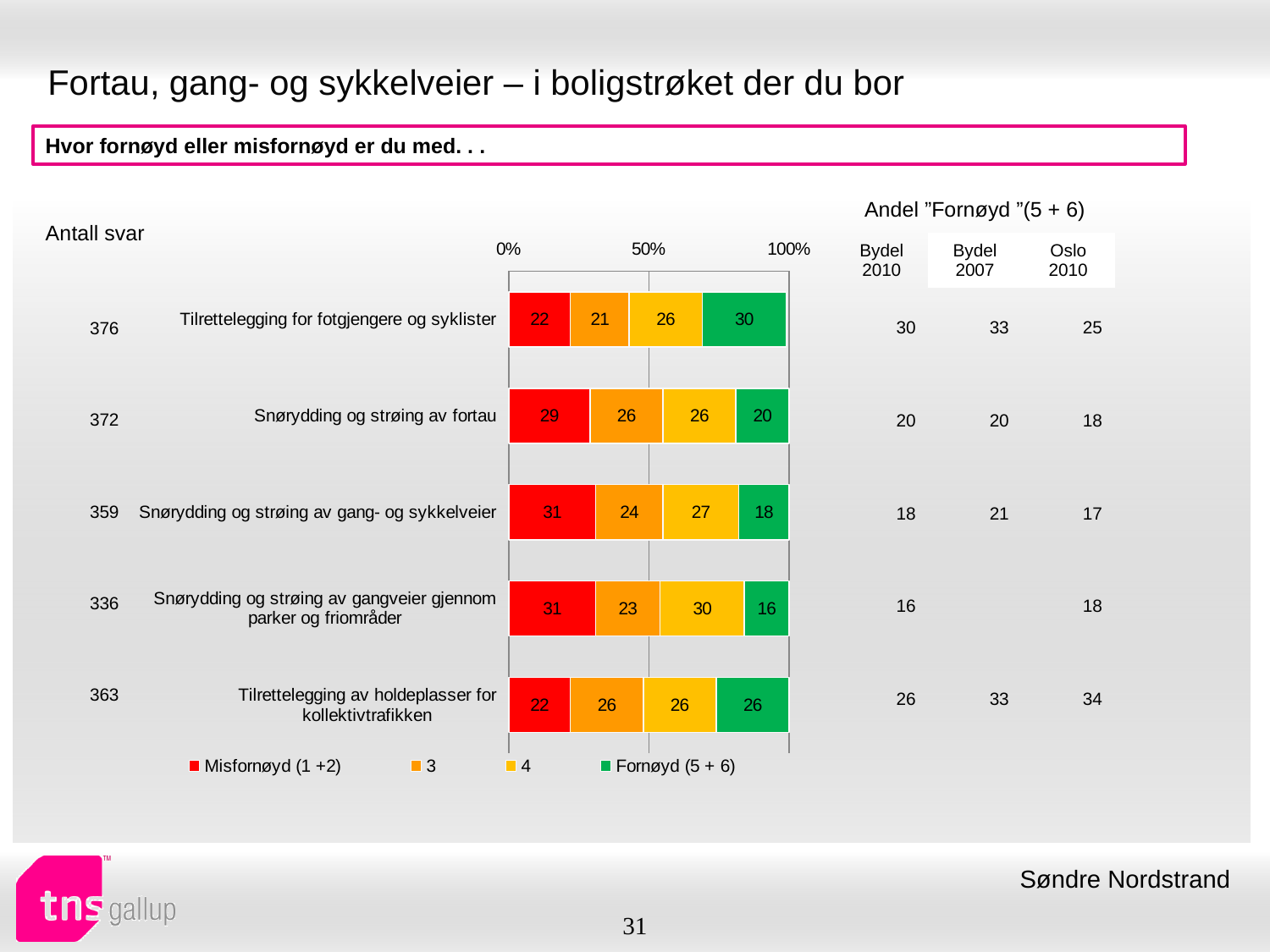
Which category has the lowest Fornøyd (5 + 6) value? Snørydding og strøing av gangveier gjennom parker og friområder How many series does the legend list? 4 What colour represents the Fornøyd (5 + 6) series in the chart? Green What kind of chart is shown on the slide? Stacked bar chart What is the difference between the Fornøyd (5 + 6) values for "Tilrettelegging for fotgjengere og syklister" and "Snørydding og strøing av gangveier gjennom parker og friområder"? 14 What is the value of the "4" segment for "Snørydding og strøing av gangveier gjennom parker og friområder"? 30 How many categories are shown in the chart? 5 What is the total of the stacked bar for "Snørydding og strøing av gang- og sykkelveier"? 100 What is the value of the Fornøyd (5 + 6) segment for "Tilrettelegging for fotgjengere og syklister"? 30 For "Snørydding og strøing av fortau", which is larger: the Misfornøyd (1 +2) segment or the Fornøyd (5 + 6) segment? Misfornøyd (1 +2) What is the value of the Misfornøyd (1 +2) segment for "Snørydding og strøing av fortau"? 29 Which category has the highest Fornøyd (5 + 6) value? Tilrettelegging for fotgjengere og syklister